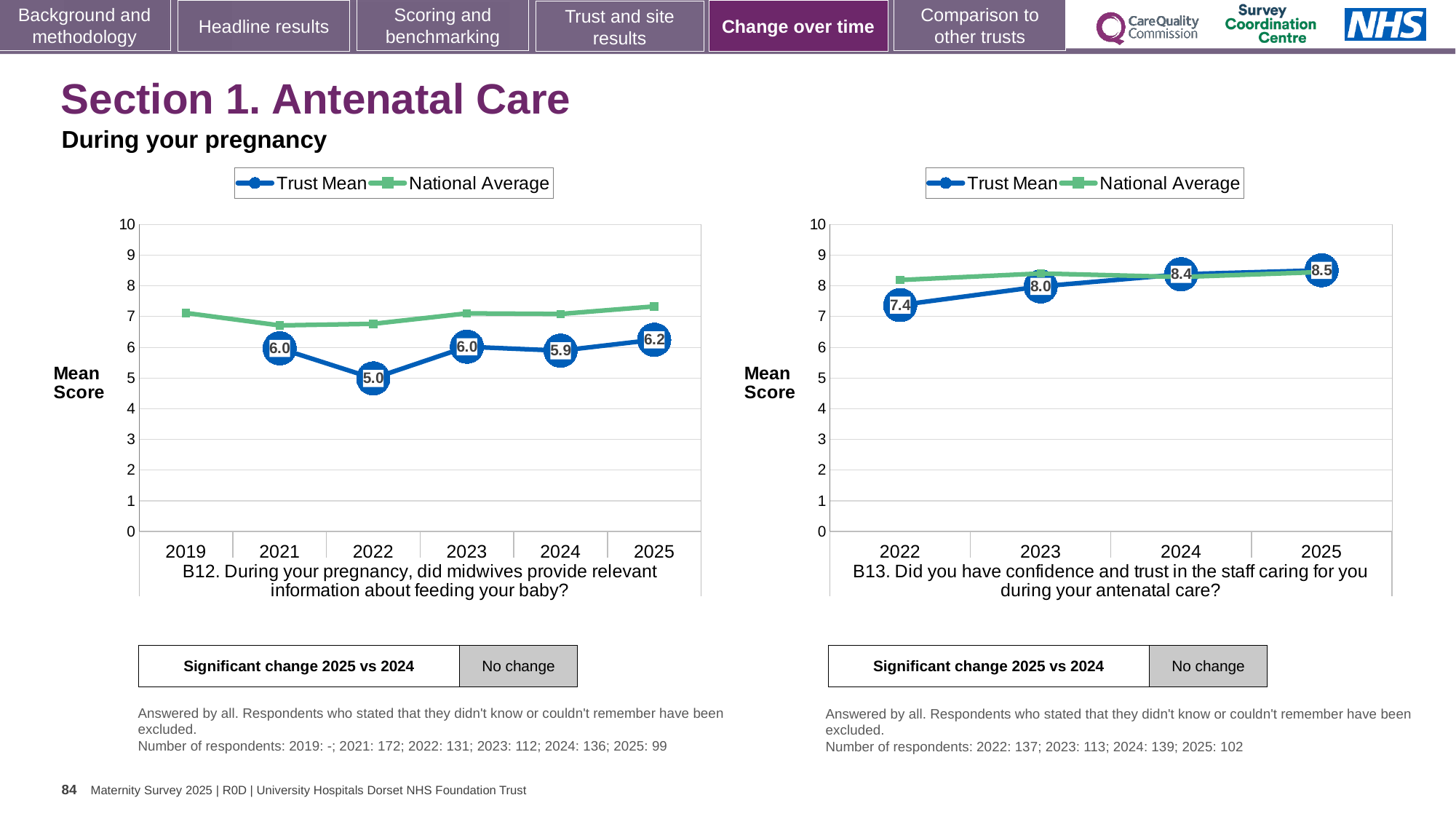
In the B13 chart (right), what is the difference between the Trust Mean scores for 2023 and 2022? 0.6 In the B12 chart (left), what is the Trust Mean score for 2022? 5.0 In the B13 chart (right), what is the Trust Mean score for 2022? 7.4 In the B13 chart (right), what is the Trust Mean score for 2025? 8.5 How many years are shown on the x axis of the B13 chart (right)? 4 In the B13 chart (right), does the Trust Mean rise or fall from 2022 to 2025? rise In the B12 chart (left), which year has the highest Trust Mean score? 2025 In the B12 chart (left), what is the difference between the Trust Mean scores for 2025 and 2022? 1.2 In the B12 chart (left), which year has the lowest Trust Mean score? 2022 In the B12 chart (left), what is the Trust Mean score for 2025? 6.2 In the B12 chart (left), is the National Average for 2025 greater or less than 7? greater How many series does the legend of the B12 chart (left) list? 2